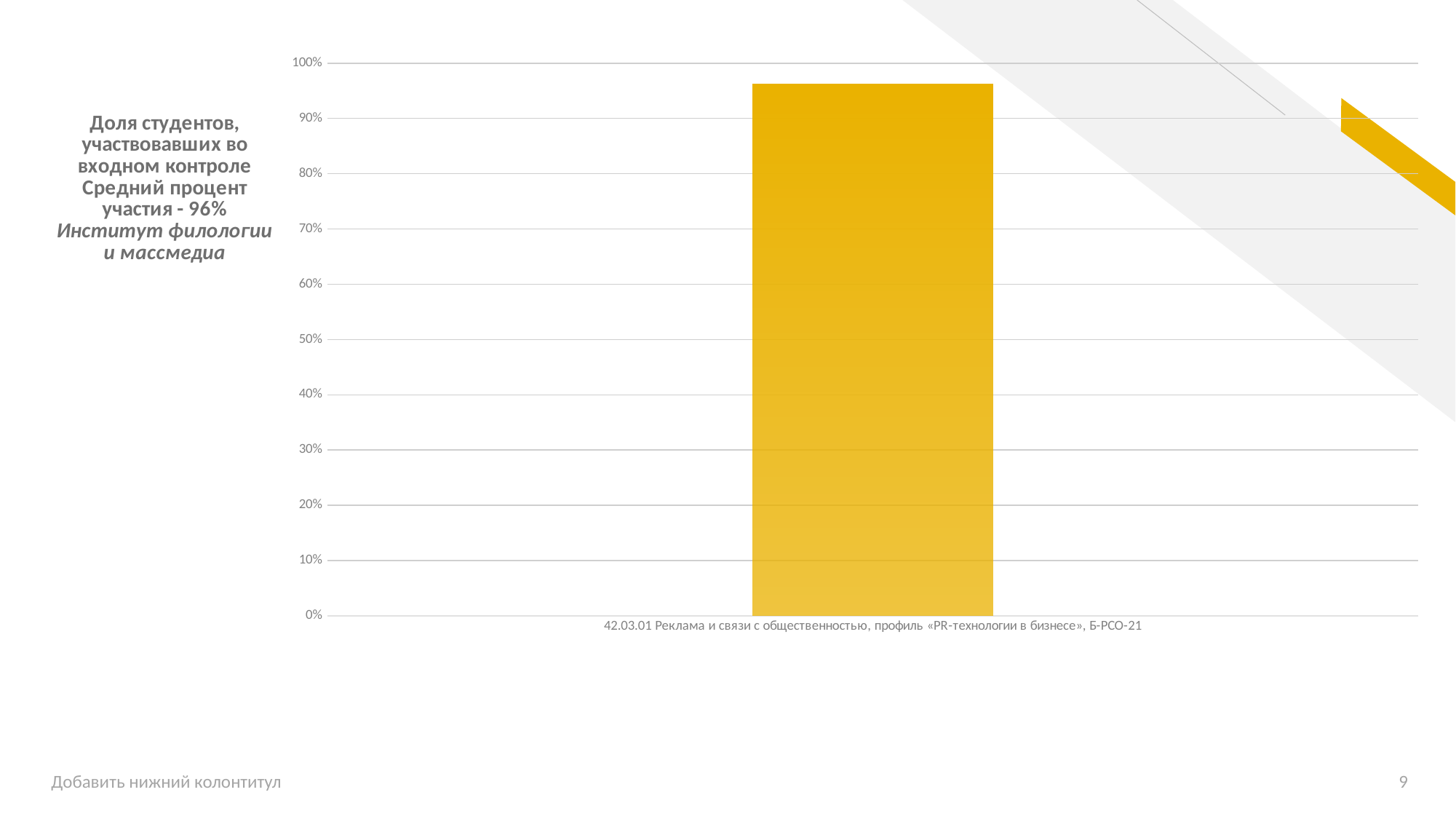
How many bars does the chart contain? 1 Is the value for 42.03.01 Реклама и связи с общественностью, профиль «PR-технологии в бизнесе», Б-РСО-21 greater or less than 90%? greater What is the highest value shown on the y axis of the chart? 100% Is the value for 42.03.01 Реклама и связи с общественностью, профиль «PR-технологии в бизнесе», Б-РСО-21 greater or less than 100%? less What kind of chart is shown on the slide? bar chart What is the category label shown on the x axis of the chart? 42.03.01 Реклама и связи с общественностью, профиль «PR-технологии в бизнесе», Б-РСО-21 What colour is the bar in the chart? yellow Is the value for 42.03.01 Реклама и связи с общественностью, профиль «PR-технологии в бизнесе», Б-РСО-21 greater or less than 50%? greater